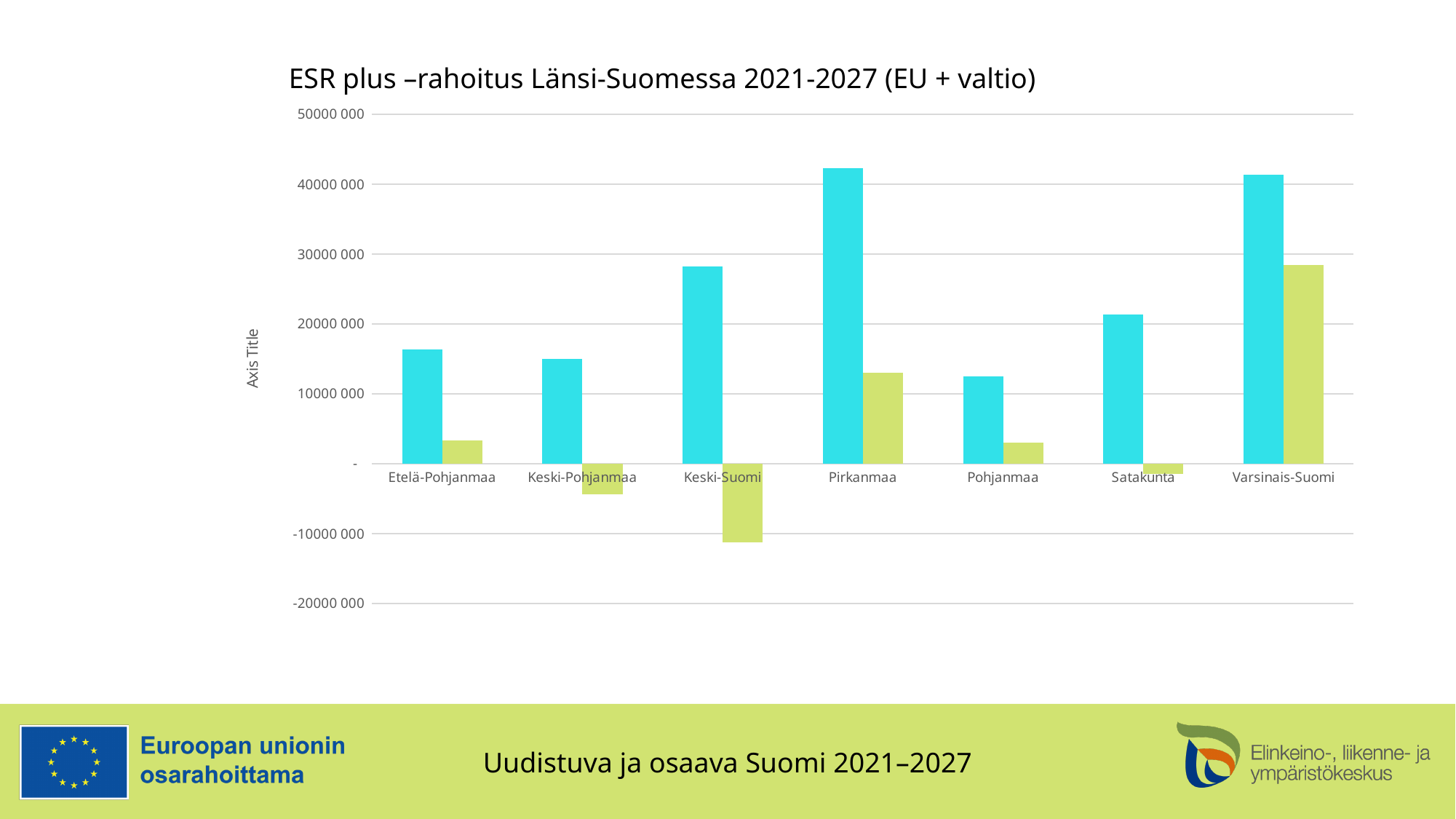
Is the green bar for Keski-Suomi greater or less than -10000 000? less What is the title of the chart? ESR plus –rahoitus Länsi-Suomessa 2021-2027 (EU + valtio) Is the cyan bar for Keski-Suomi greater or less than 30000 000? less Which region has the highest green bar in the chart? Varsinais-Suomi How many bars are plotted for each region in the chart? 2 Which region has the larger green bar, Pirkanmaa or Pohjanmaa? Pirkanmaa What kind of chart is shown on the slide? bar chart Which region has the lowest green bar in the chart? Keski-Suomi Which region has the lowest cyan bar in the chart? Pohjanmaa Which region has the larger cyan bar, Keski-Suomi or Satakunta? Keski-Suomi Is the cyan bar for Pirkanmaa greater or less than 40000 000? greater How many regions (categories) are shown on the x axis of the chart? 7